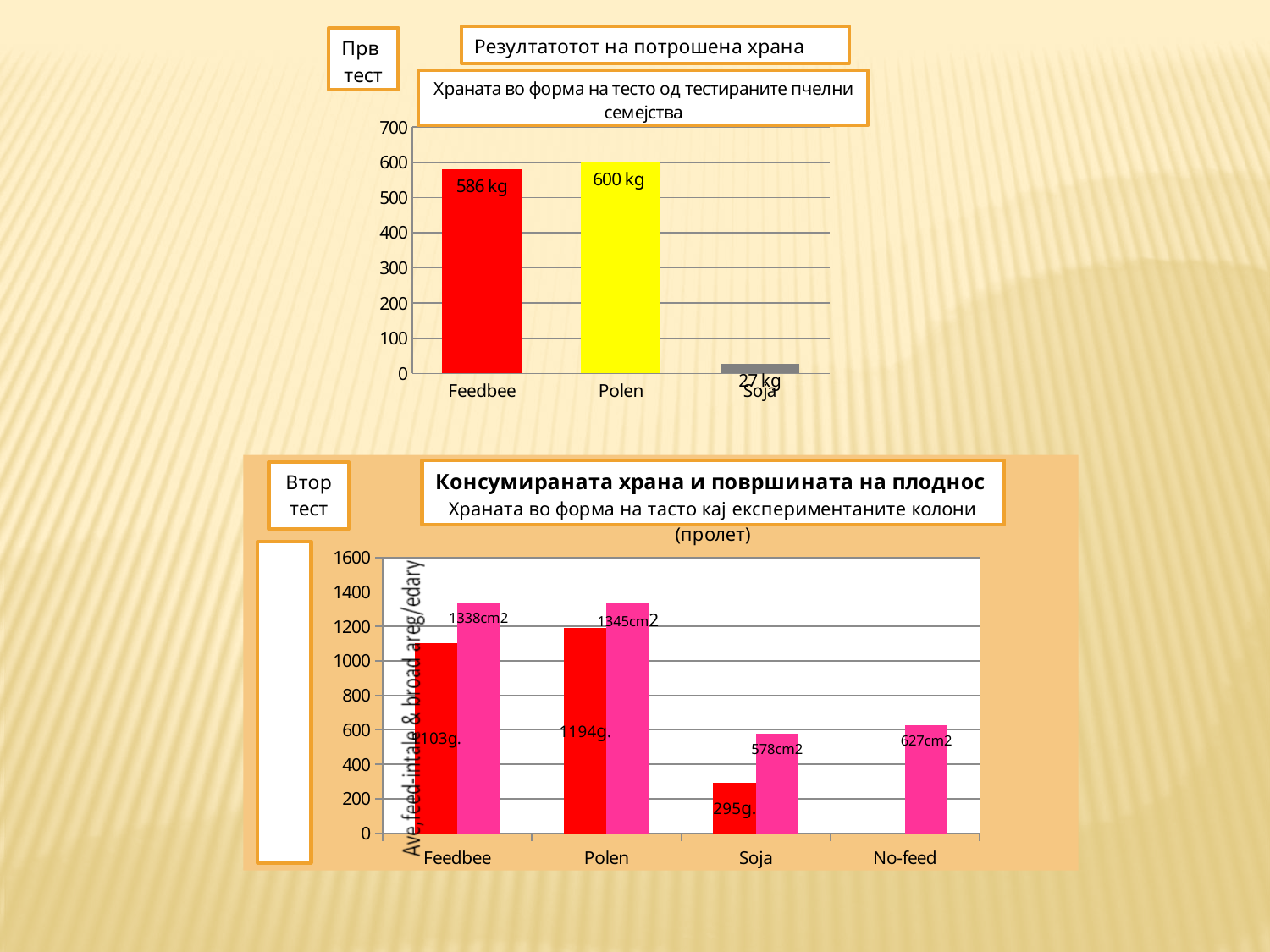
In the top chart, how many categories are shown on the x axis? 3 In the top chart, what is the value for Soja? 27 kg In the bottom chart, is the feed intake value for Feedbee greater or less than 1000? greater In the top chart, which category has the lowest value? Soja In the bottom chart, what is the brood area value (cm2) for No-feed? 627cm2 What kind of chart is the top chart? Bar chart In the top chart, what is the value for Polen? 600 kg In the bottom chart, what is the brood area value (cm2) for Polen? 1345cm2 In the bottom chart, what is the feed intake value (g) for Soja? 295g. In the top chart, what is the value for Feedbee? 586 kg In the top chart, what is the difference between the Polen and Feedbee values? 14 kg In the bottom chart, how many categories are shown on the x axis? 4